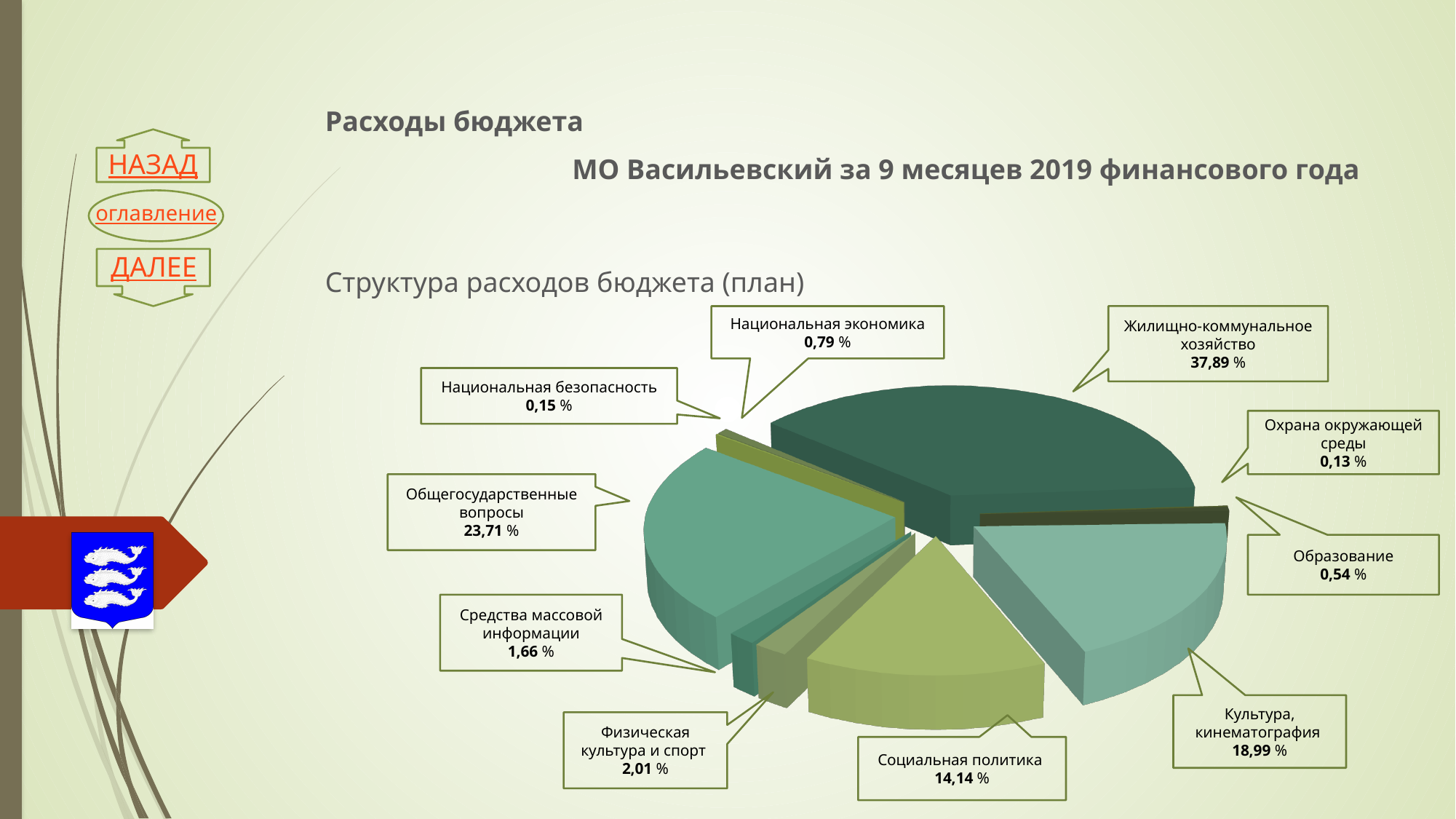
Which is larger: Культура, кинематография or Социальная политика? Культура, кинематография Which category has the largest share of the pie? Жилищно-коммунальное хозяйство Which category has the smallest share of the pie? Охрана окружающей среды How many categories are shown in the pie chart? 10 What is the difference between the shares of Культура, кинематография and Социальная политика? 4,85 % What kind of chart is shown on the slide? Pie chart What is the value shown for Физическая культура и спорт? 2,01 % What is the title of the chart? Структура расходов бюджета (план) What is the value shown for Общегосударственные вопросы? 23,71 % What is the value shown for Социальная политика? 14,14 % What is the difference between the shares of Жилищно-коммунальное хозяйство and Общегосударственные вопросы? 14,18 % What share of the pie is Жилищно-коммунальное хозяйство? 37,89 %